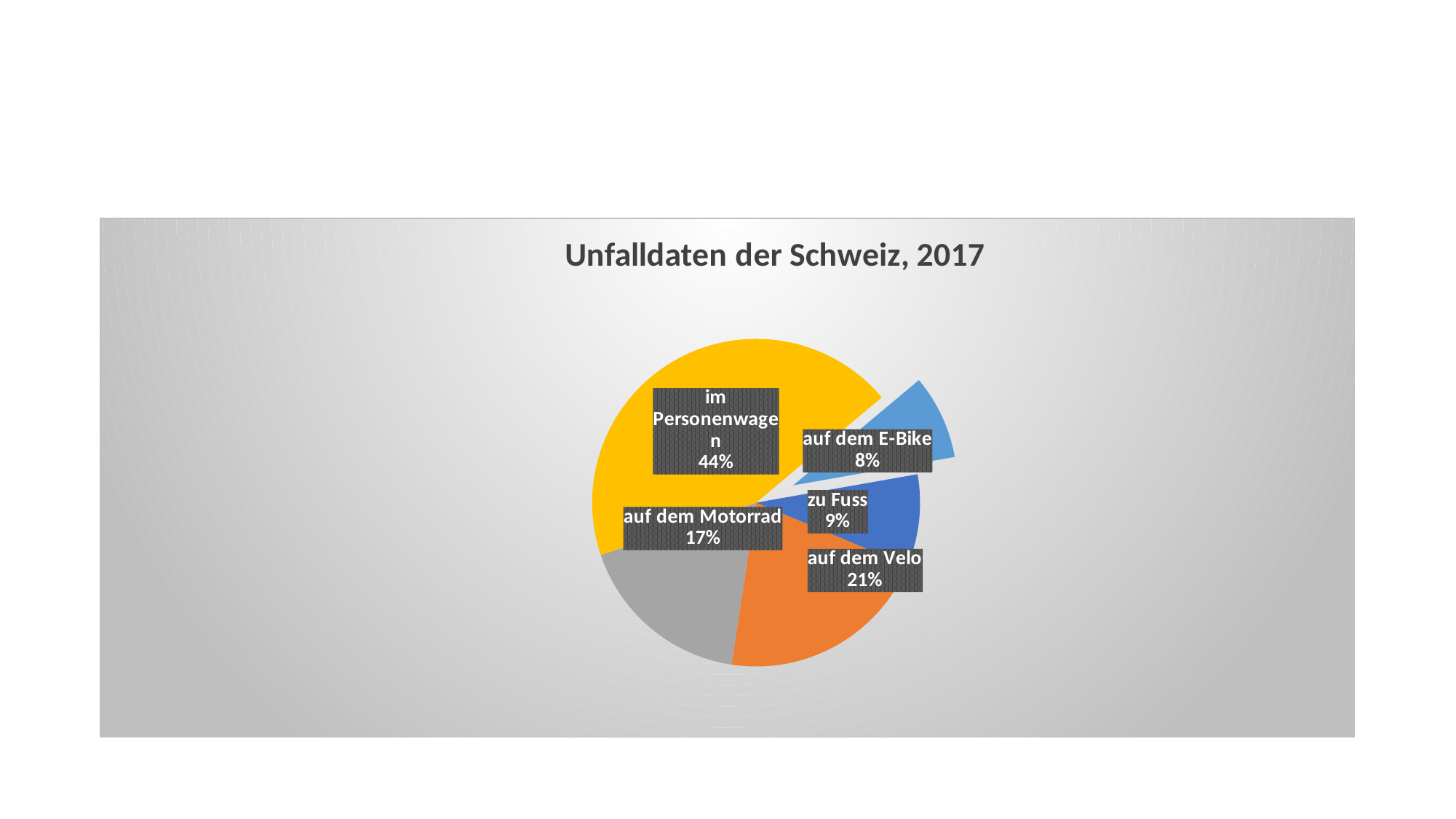
What share of the pie is 'auf dem Motorrad'? 17% What is the title of the chart? Unfalldaten der Schweiz, 2017 What share of the pie is 'auf dem E-Bike'? 8% What share of the pie is 'im Personenwagen'? 44% Which category has the largest share of the pie? im Personenwagen What is the difference in percentage points between 'auf dem Velo' and 'auf dem Motorrad'? 4 Which category has the smallest share of the pie? auf dem E-Bike What kind of chart is shown on the slide? pie chart How many categories (slices) does the pie chart have? 5 Which is larger, the share for 'zu Fuss' or the share for 'auf dem E-Bike'? zu Fuss